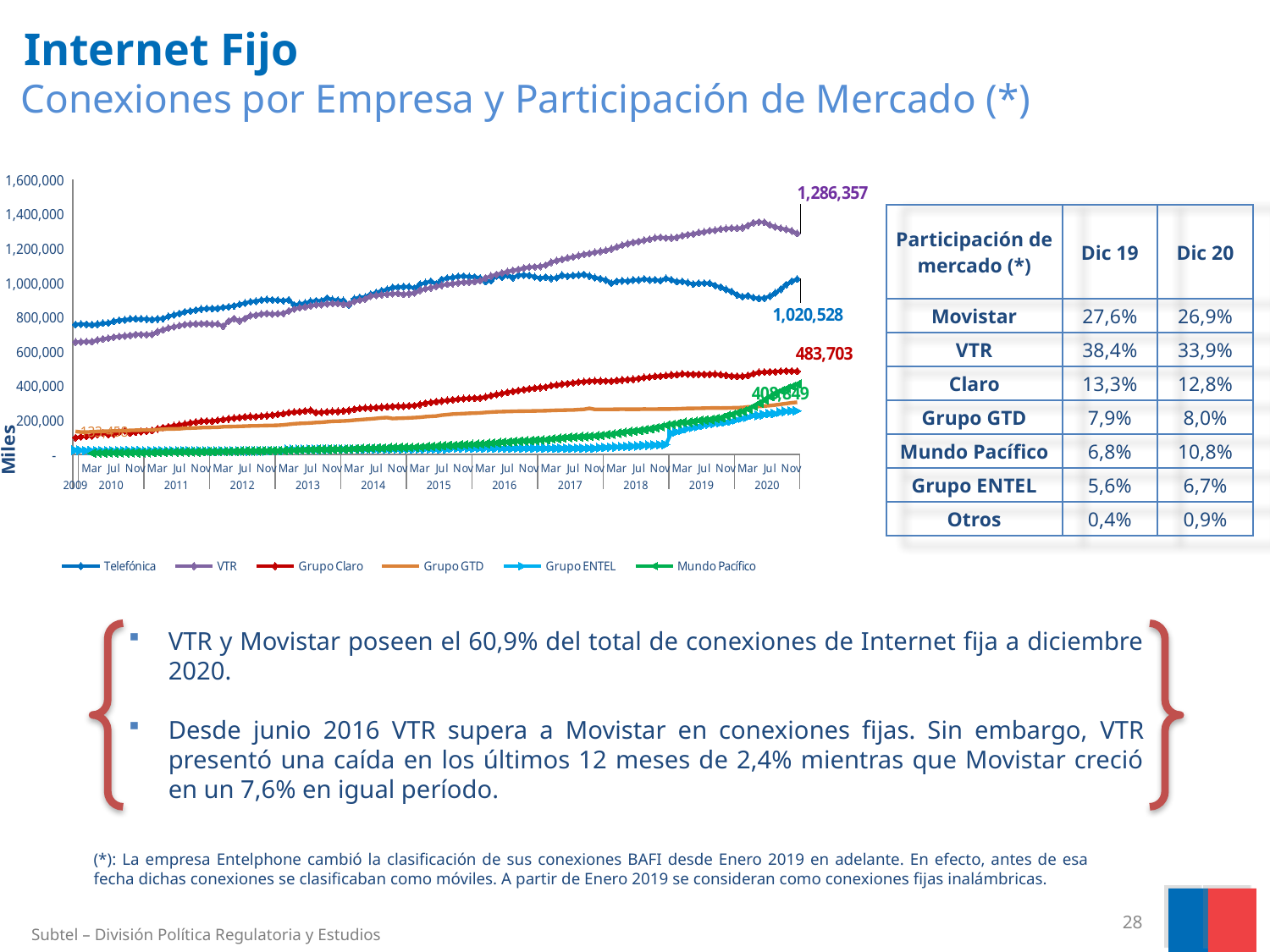
Does the VTR line rise or fall overall from 2009 to 2020? rise What is the difference between the final labelled values of VTR and Grupo Claro? 802,654 What is the final labelled value for VTR on the chart? 1,286,357 What is the final labelled value for Telefónica on the chart? 1,020,528 At the end of 2020, which is larger on the chart: Telefónica or Grupo Claro? Telefónica What kind of chart is shown on the slide? line chart Which series has the highest value at the end of 2020 on the chart? VTR Is the value for Grupo ENTEL at the end of 2020 greater or less than 400,000? less At the start of the chart in 2009, which series is higher: Telefónica or VTR? Telefónica What is the difference between the final labelled values of VTR and Telefónica? 265,829 What is the final labelled value for Grupo Claro on the chart? 483,703 How many series does the chart legend list? 6